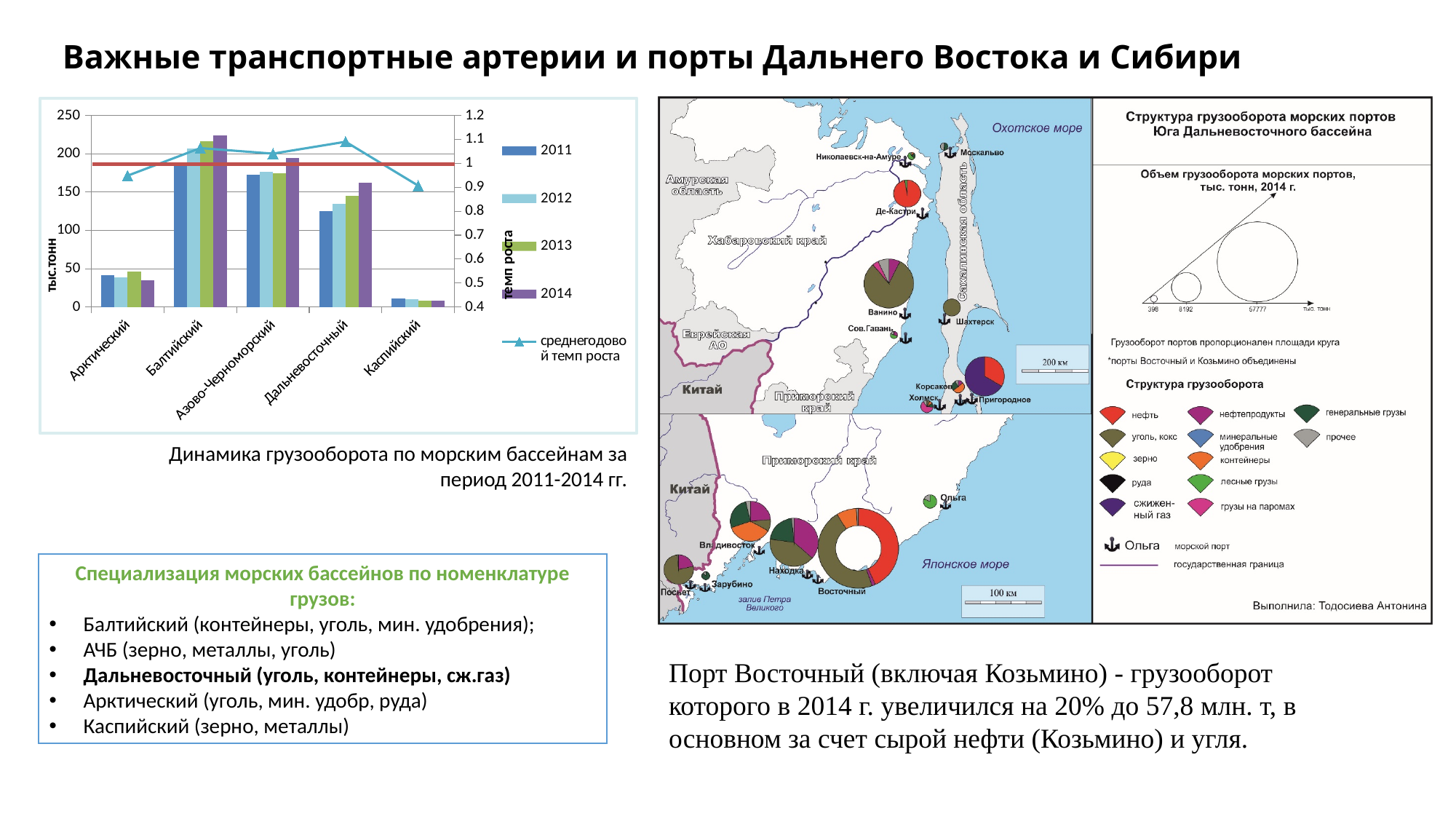
How many series does the legend of the left chart list? 5 In the left chart, do the values for Дальневосточный rise or fall from 2011 to 2014? rise In the left chart, is the 2014 value for Азово-Черноморский greater or less than 200? less In the left chart, which is larger in 2014: Балтийский or Дальневосточный? Балтийский In the left chart, which basin has the lowest cargo turnover bars? Каспийский In the left chart, is the 2014 value for Арктический greater or less than 50? less In the left chart, is the 2014 value for Балтийский greater or less than 200? greater What is the caption (title) given under the left chart? Динамика грузооборота по морским бассейнам за период 2011-2014 гг. What kind of chart is the chart on the left of the slide? bar chart with a line In the left chart, which basin has the highest cargo turnover bars? Балтийский How many sea basins (categories) are shown on the x axis of the left chart? 5